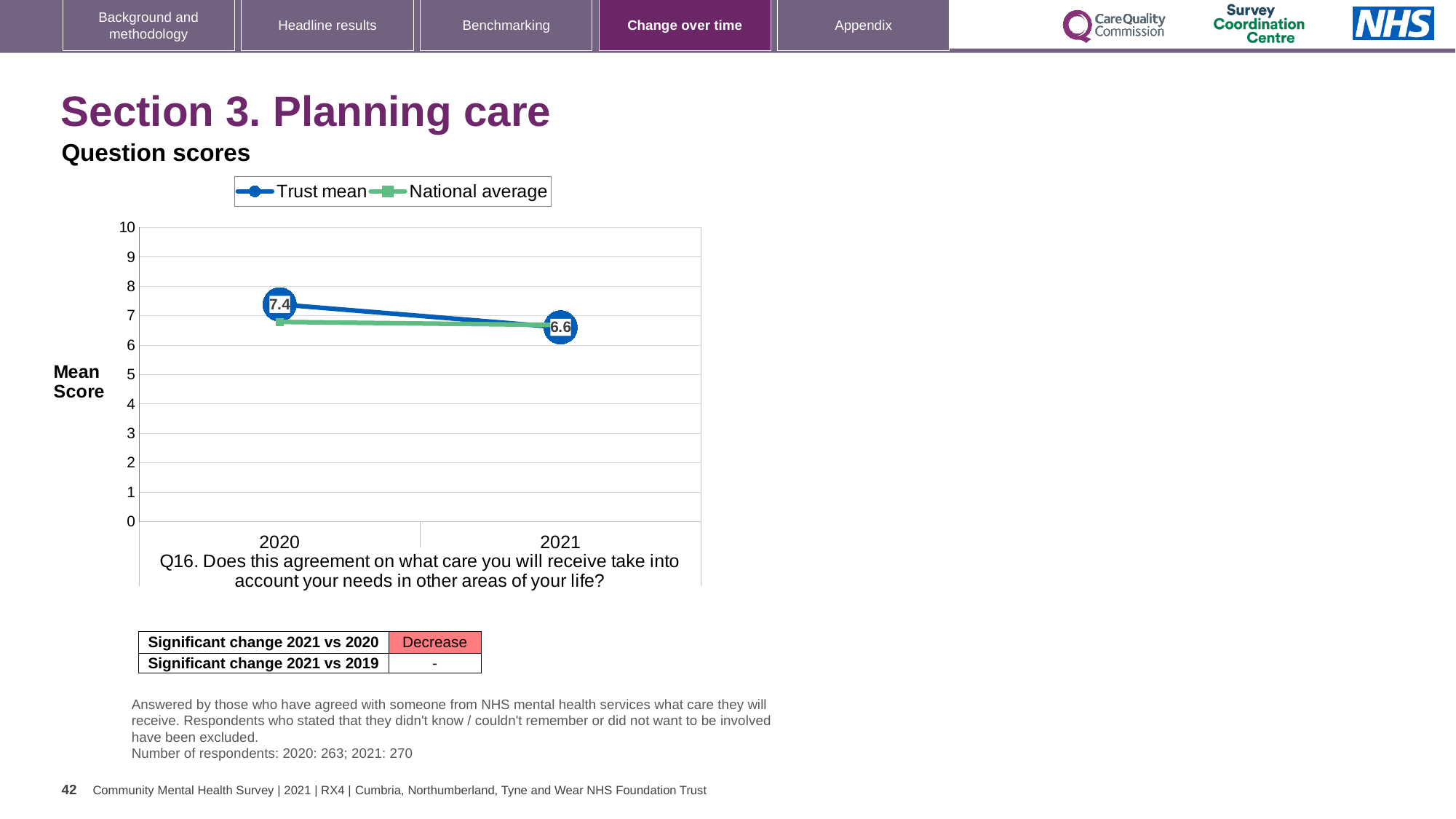
How many years are shown on the x axis of the chart? 2 In 2020, which is higher, the Trust mean or the National average? Trust mean By how much did the Trust mean score change from 2020 to 2021? 0.8 Does the Trust mean rise or fall from 2020 to 2021? fall What kind of chart is shown on the slide? line chart What is the Trust mean score for 2020? 7.4 How many series does the chart legend list? 2 Is the National average for 2020 greater or less than 5? greater What is the Trust mean score for 2021? 6.6 Which is larger, the Trust mean for 2020 or the Trust mean for 2021? 2020 In which year is the Trust mean lowest? 2021 In which year is the Trust mean highest? 2020